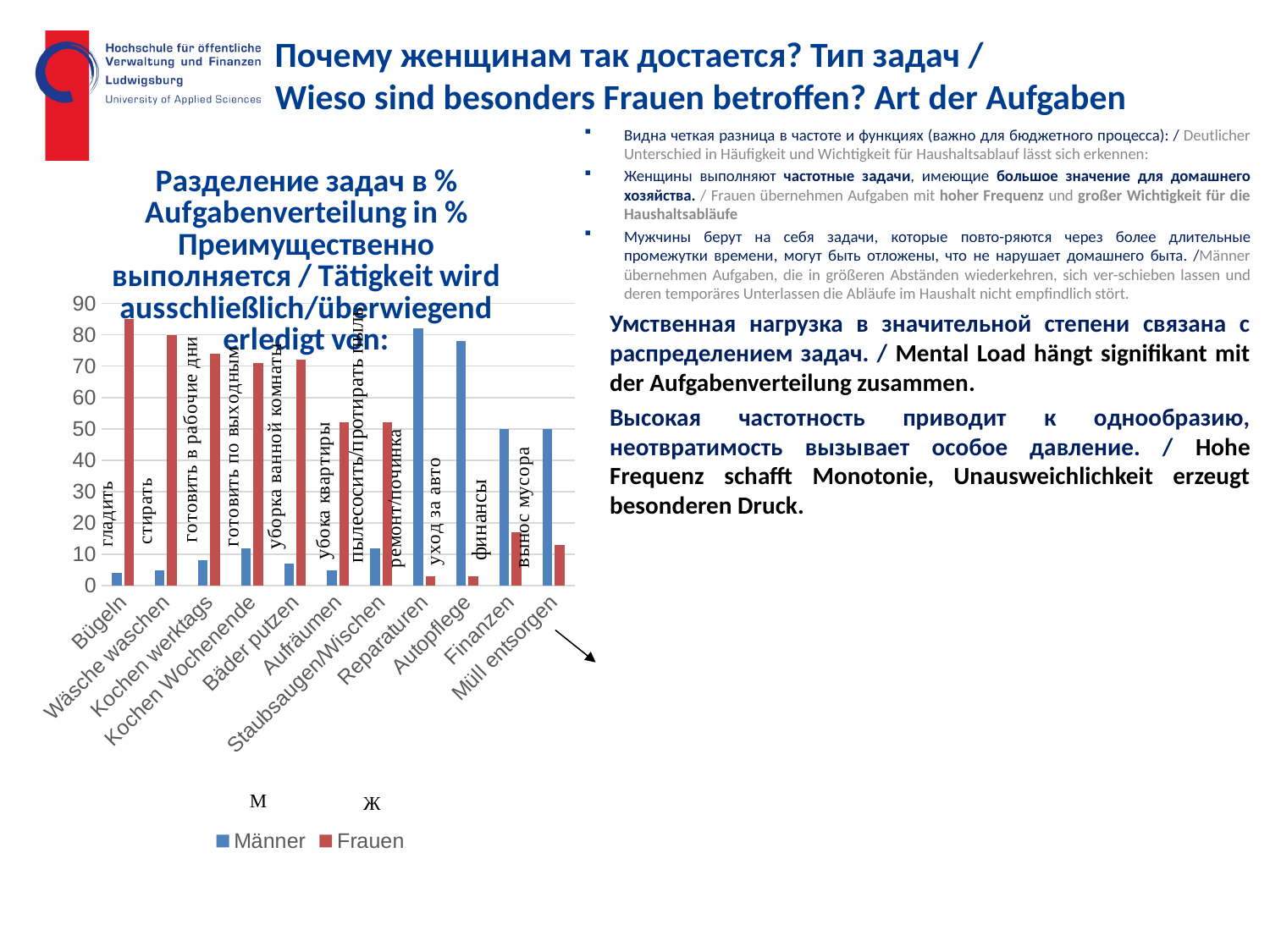
For Reparaturen, which series has the larger value, Männer or Frauen? Männer Is the Männer value for Reparaturen greater or less than 70? greater Is the Frauen value for Bügeln greater or less than 80? greater How many task categories are shown on the x axis of the chart? 11 Is the Frauen value for Müll entsorgen greater or less than 20? less Which series is shown in red in the chart? Frauen Which series is shown in blue in the chart? Männer How many series does the chart legend list? 2 For Bügeln, which series has the larger value, Männer or Frauen? Frauen What kind of chart is shown on the slide? bar chart